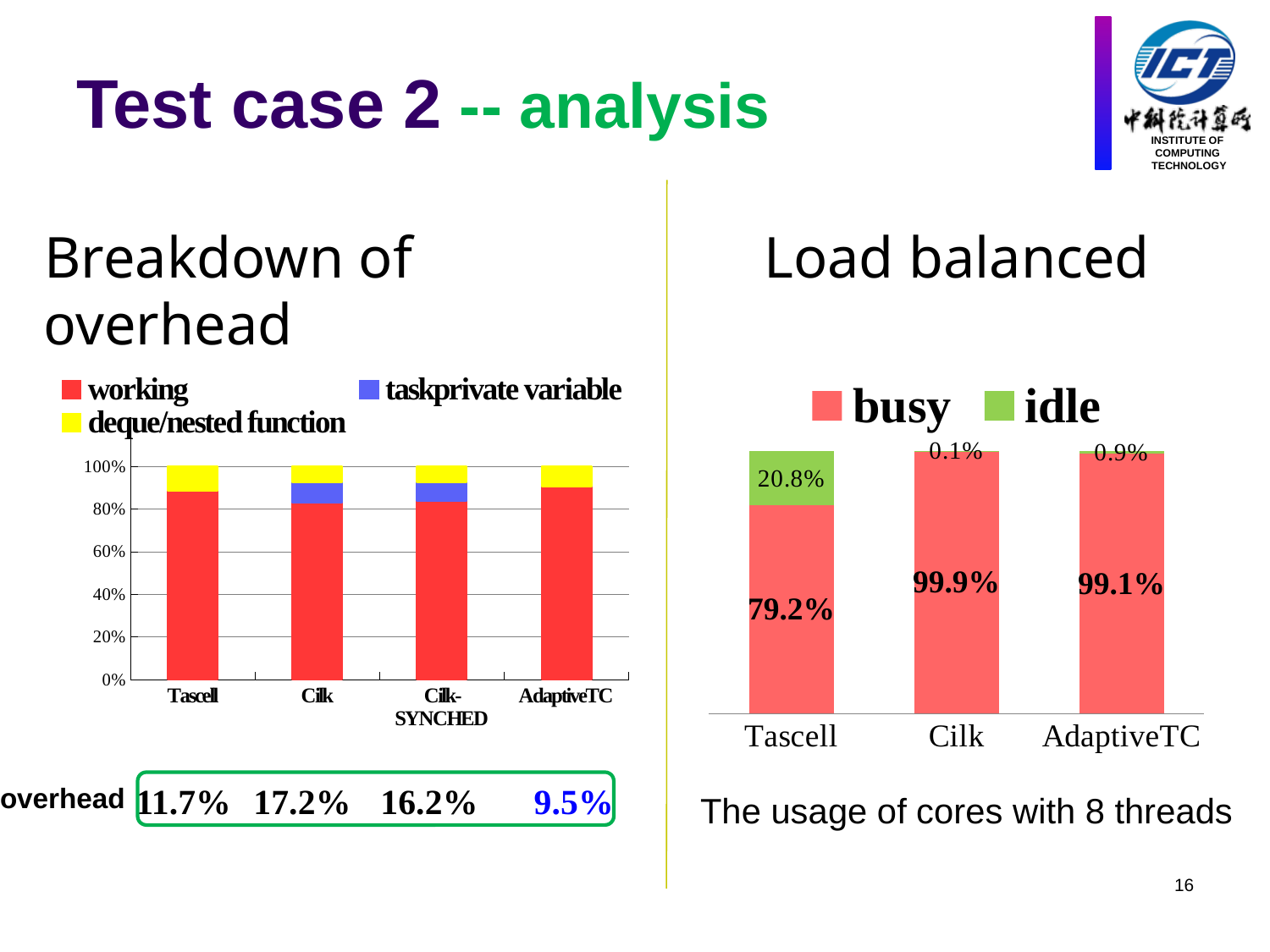
In the Load balanced chart, which category has the lowest busy value? Tascell In the Load balanced chart, what is the idle value for AdaptiveTC? 0.9% In the Breakdown of overhead chart, how many series does the legend list? 3 In the Load balanced chart, what is the busy value for Tascell? 79.2% In the Load balanced chart, how many series does the legend list? 2 In the Load balanced chart, what is the idle value for Tascell? 20.8% In the Load balanced chart, what is the busy value for Cilk? 99.9% In the Load balanced chart, what is the difference between the busy values of Cilk and AdaptiveTC? 0.8% In the Load balanced chart, which category has the highest idle value? Tascell In the Breakdown of overhead chart, how many categories are shown on the x axis? 4 In the Breakdown of overhead chart, is the working value for Tascell greater or less than 80%? greater What kind of chart is the Breakdown of overhead chart? Stacked bar chart